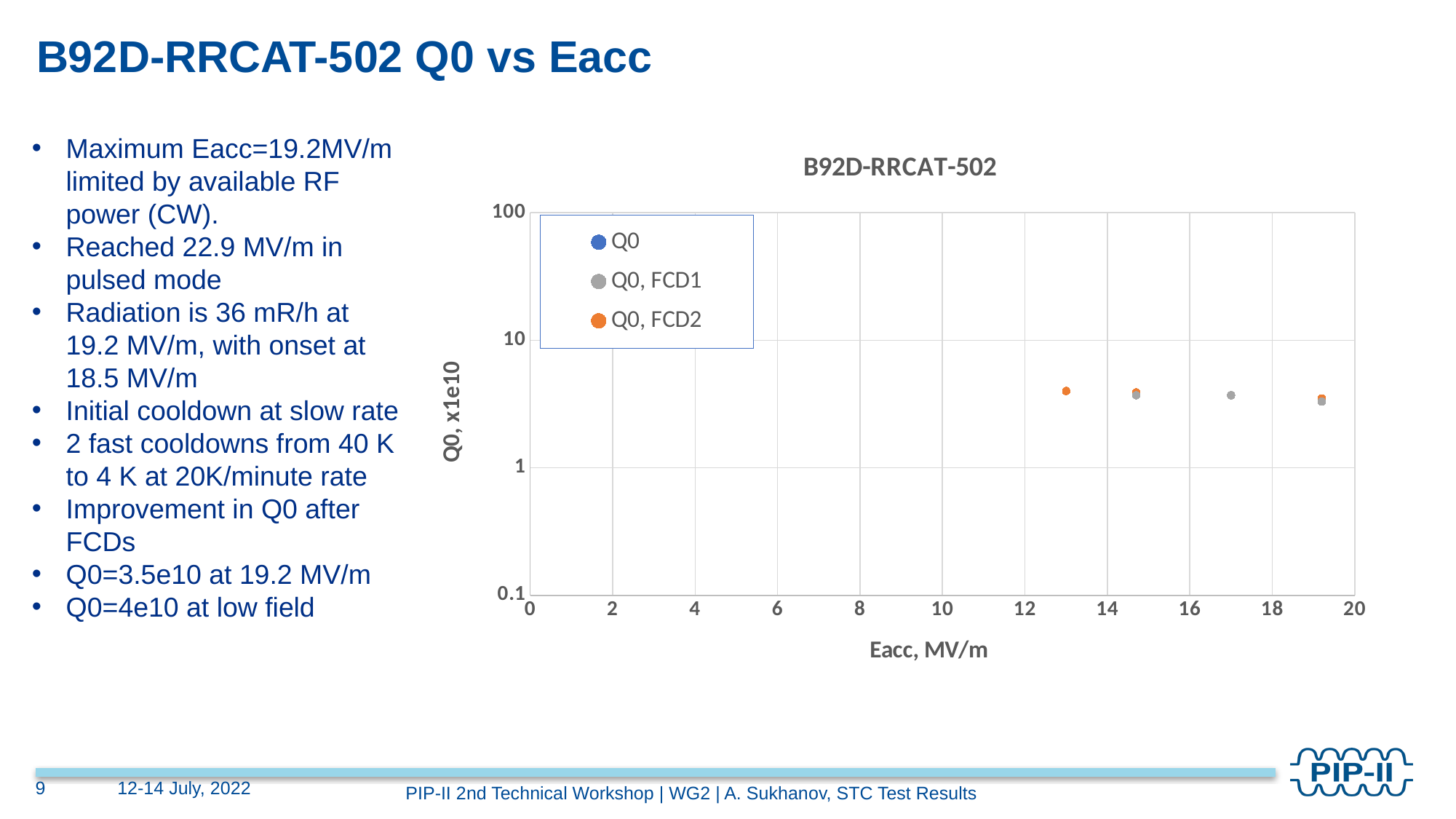
What is the highest value shown on the y axis of the chart? 100 How many series does the chart legend list? 3 What is the title of the chart? B92D-RRCAT-502 Is the Q0, FCD2 value at about 13 MV/m greater or less than 10? less Is the Q0, FCD1 value at about 19 MV/m greater or less than 1? greater Is the Q0, FCD2 value at about 13 MV/m greater or less than 1? greater What kind of chart is shown on the slide? scatter plot Do the plotted Q0 values rise or fall as Eacc increases from about 13 to about 19 MV/m? fall What is the label of the x axis of the chart? Eacc, MV/m